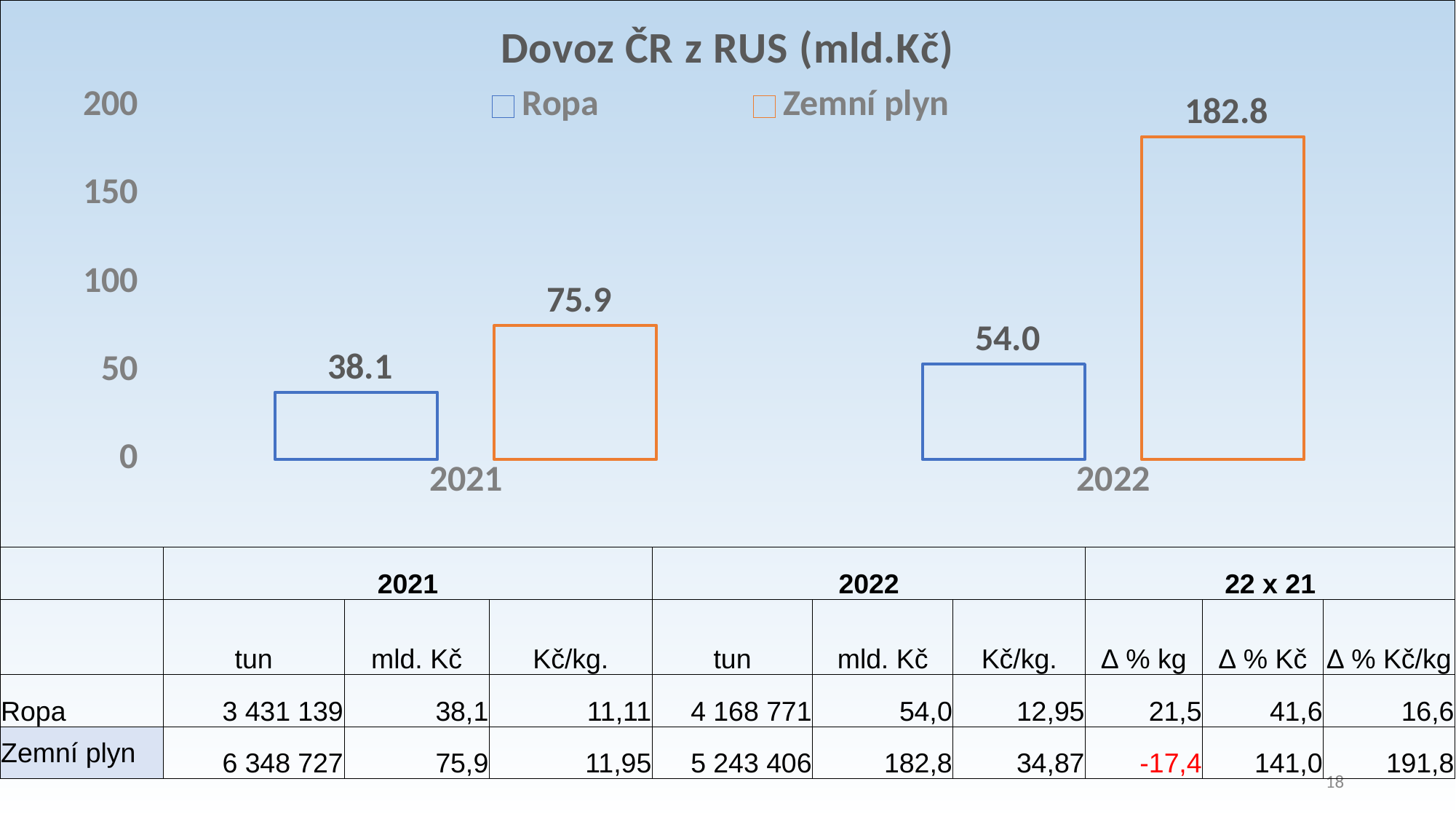
How many series does the legend list? 2 Which bar has the lowest value in the chart? Ropa in 2021 What is the difference between Zemní plyn in 2022 and Zemní plyn in 2021? 106.9 What is the value for Ropa in 2021? 38.1 Do the values for Zemní plyn rise or fall from 2021 to 2022? Rise Which series has the highest value in the chart? Zemní plyn What is the difference between Ropa in 2022 and Ropa in 2021? 15.9 What is the value for Zemní plyn in 2021? 75.9 What is the value for Ropa in 2022? 54.0 Which is larger in 2022, Ropa or Zemní plyn? Zemní plyn What is the value for Zemní plyn in 2022? 182.8 What kind of chart is shown on the slide? Bar chart